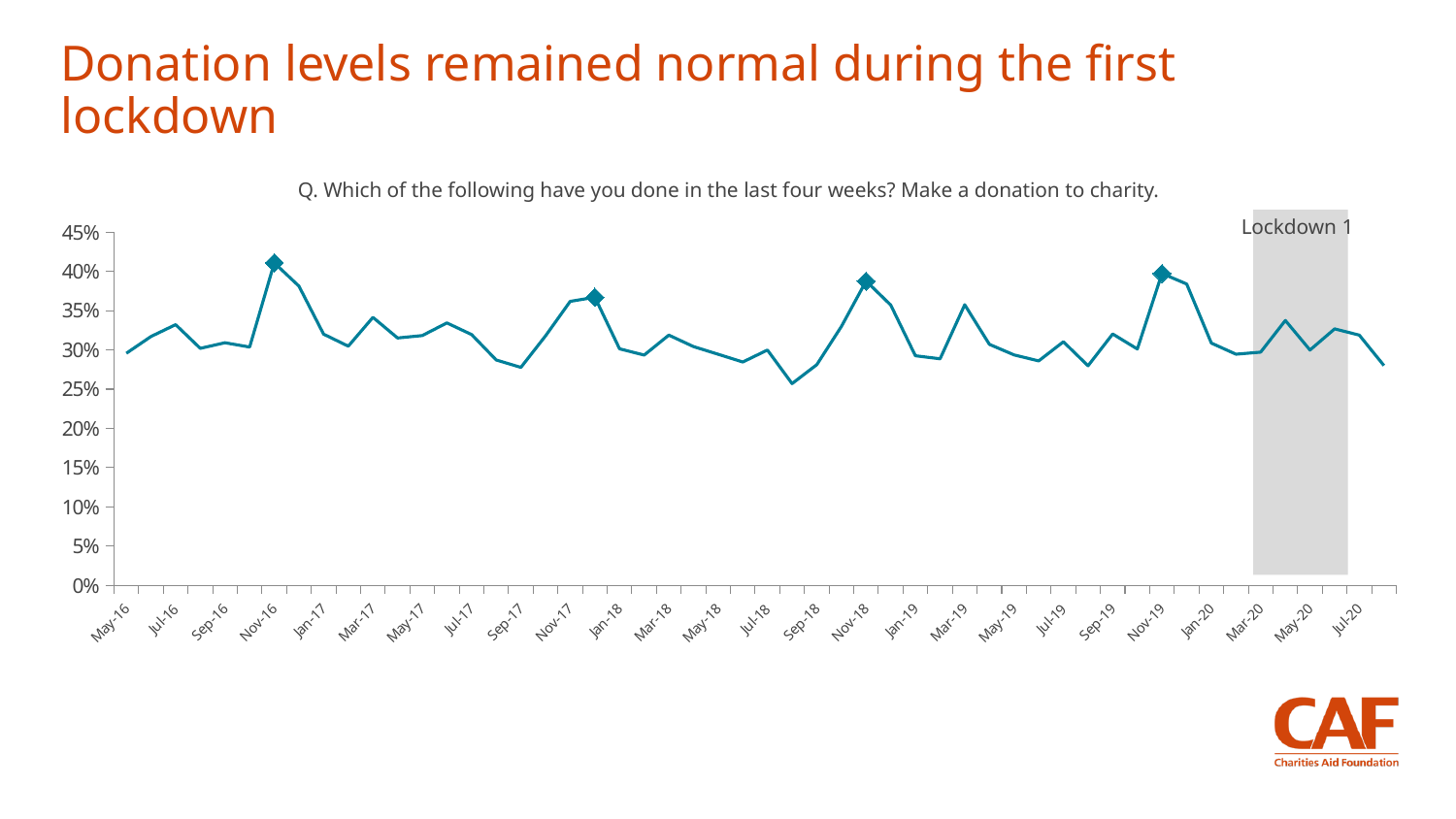
Does the line rise or fall between Nov-16 and Jan-17? fall Is the value for Nov-16 greater or less than 35%? greater Is the value for Sep-17 greater or less than 30%? less What kind of chart is shown on the slide? line chart Does the line rise or fall between Sep-18 and Nov-18? rise Is the value for Nov-19 greater or less than 35%? greater What label is shown on the shaded region at the right of the chart? Lockdown 1 What is the title of the slide? Donation levels remained normal during the first lockdown Which is larger, the value for Nov-16 or the value for Jan-17? Nov-16 How many month labels are shown on the x axis? 26